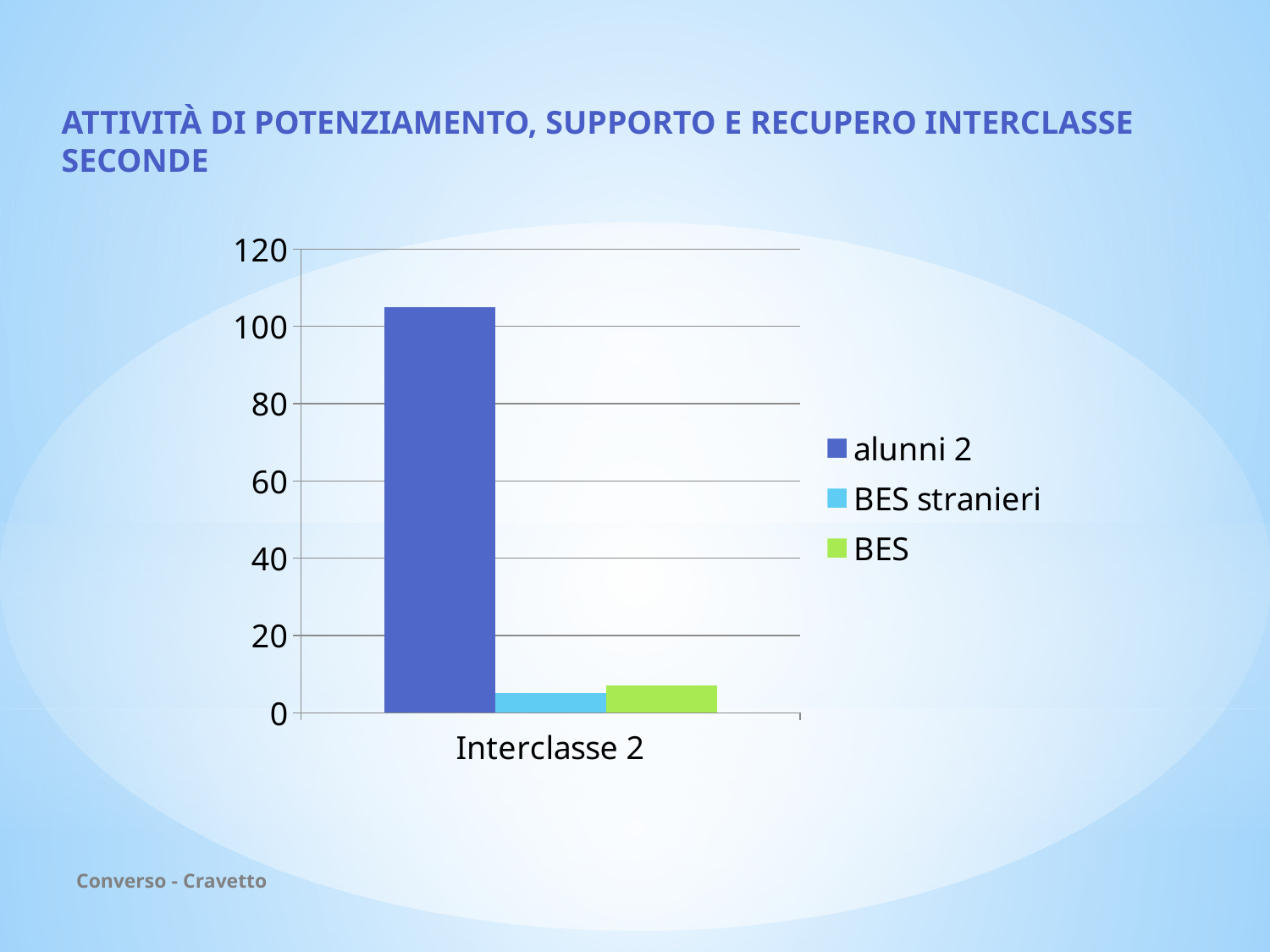
Which series has the lowest value for Interclasse 2? BES stranieri What kind of chart is shown on the slide? bar chart How many categories are shown on the x axis? 1 What colour is the bar for the alunni 2 series? blue How many series does the legend list? 3 Which is larger, the value for BES or the value for BES stranieri? BES What is the label of the category on the x axis? Interclasse 2 Is the value for BES stranieri greater or less than 20? less Which is larger, the value for alunni 2 or the value for BES? alunni 2 Is the value for BES greater or less than 20? less Which series has the highest value for Interclasse 2? alunni 2 Is the value for alunni 2 greater or less than 100? greater